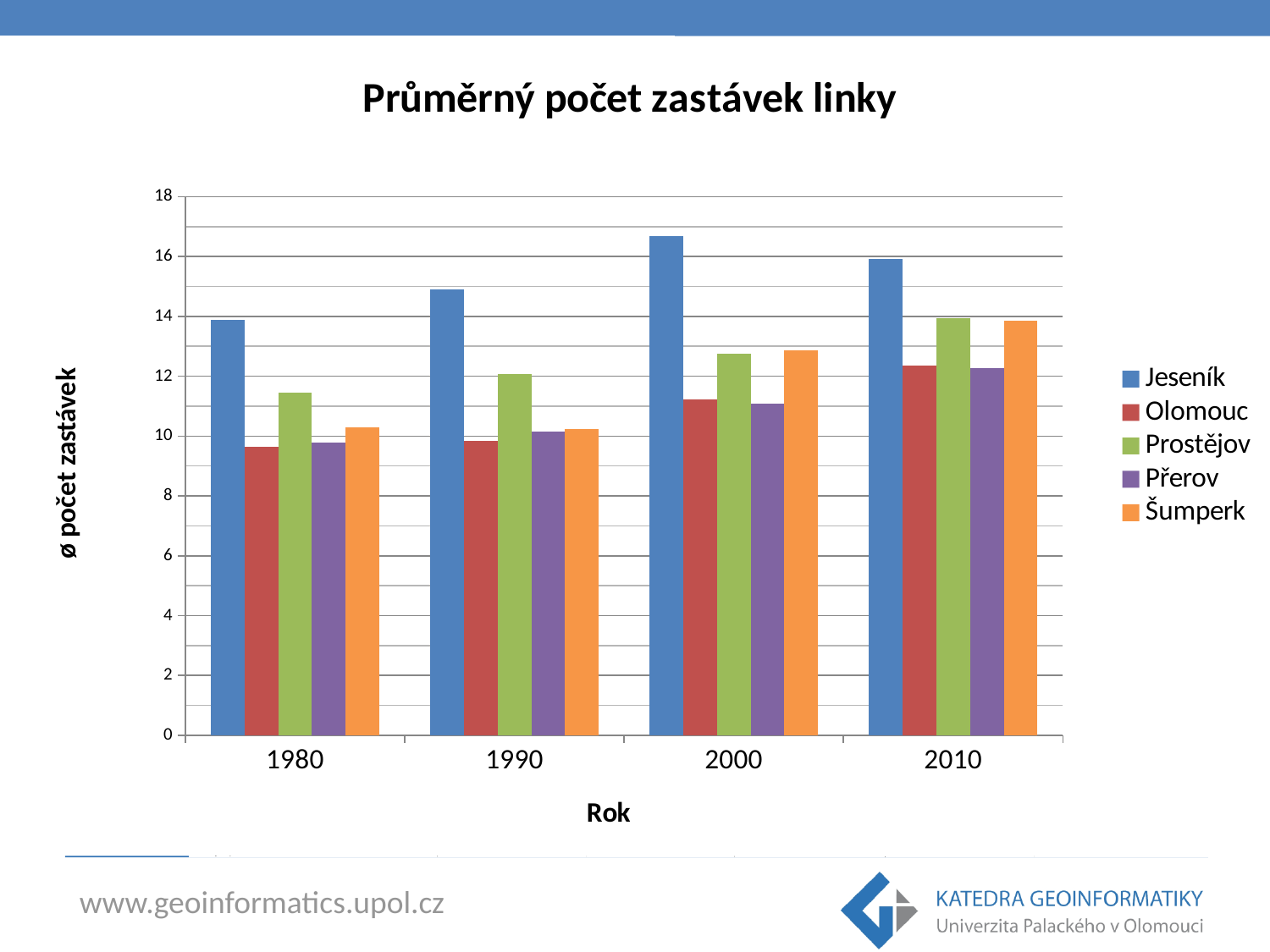
Do the values for Olomouc rise or fall from 1980 to 2010? rise Is the value for Šumperk in 2000 greater or less than 12? greater In which year is the value for Jeseník the lowest? 1980 Is the value for Olomouc in 1980 greater or less than 10? less What kind of chart is shown on the slide? bar chart Which is larger in 1990, the value for Jeseník or the value for Prostějov? Jeseník Is the value for Jeseník in 2000 greater or less than 16? greater Which series has the highest value in 2000? Jeseník How many years are shown on the x axis? 4 In which year is the value for Jeseník the highest? 2000 What is the title of the x axis? Rok How many series does the legend list? 5